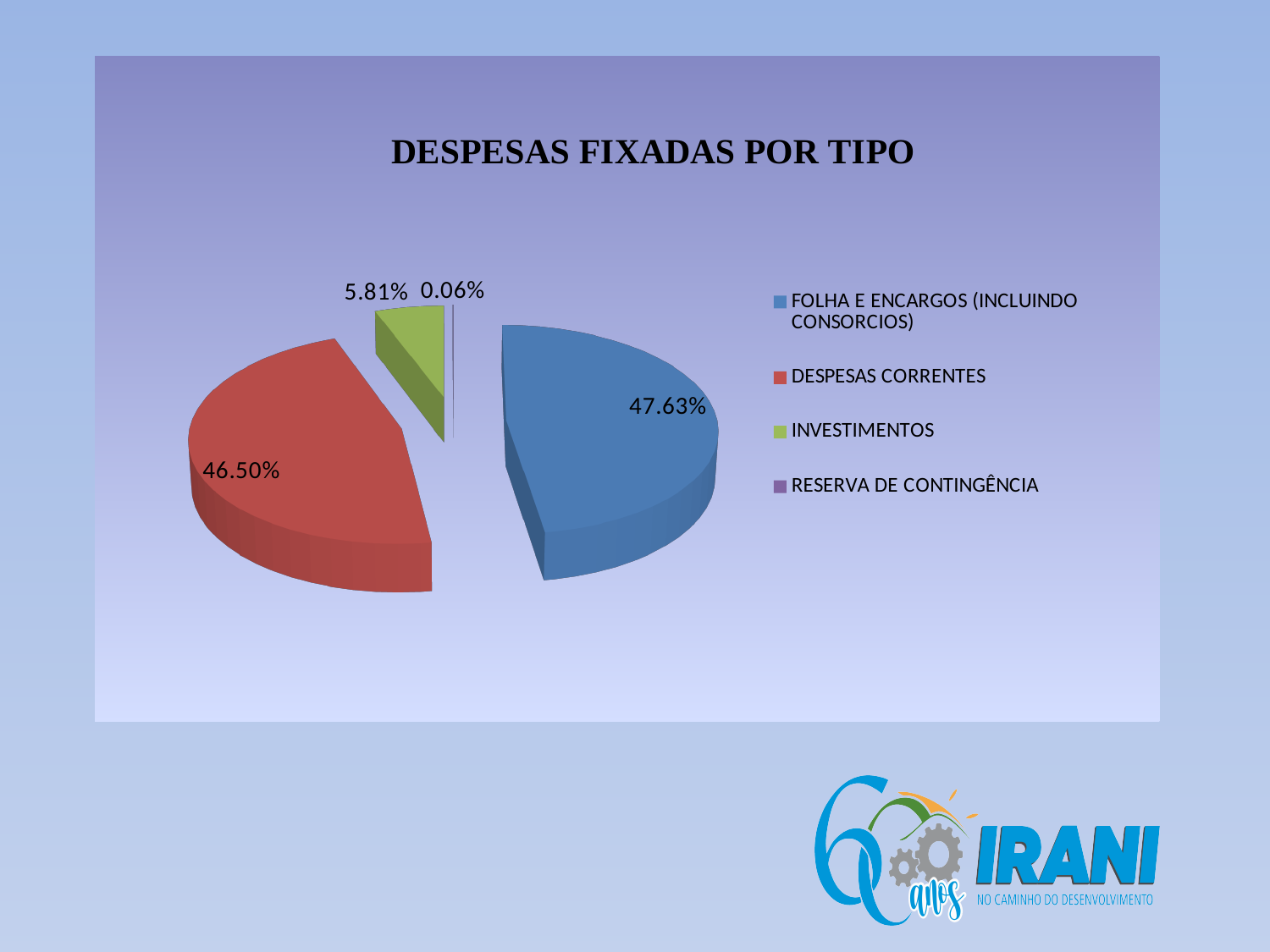
What is the difference in percentage points between FOLHA E ENCARGOS (INCLUINDO CONSORCIOS) and DESPESAS CORRENTES? 1.13 Which is larger, the share for INVESTIMENTOS or the share for RESERVA DE CONTINGÊNCIA? INVESTIMENTOS What colour is the slice for DESPESAS CORRENTES? Red What percentage is shown for RESERVA DE CONTINGÊNCIA? 0.06% What kind of chart is shown on the slide? Pie chart What percentage is shown for DESPESAS CORRENTES? 46.50% What is the title of the chart? DESPESAS FIXADAS POR TIPO How many categories does the legend list? 4 Which category has the largest share of the pie? FOLHA E ENCARGOS (INCLUINDO CONSORCIOS) Which category has the smallest share of the pie? RESERVA DE CONTINGÊNCIA What percentage is shown for FOLHA E ENCARGOS (INCLUINDO CONSORCIOS)? 47.63% What percentage is shown for INVESTIMENTOS? 5.81%